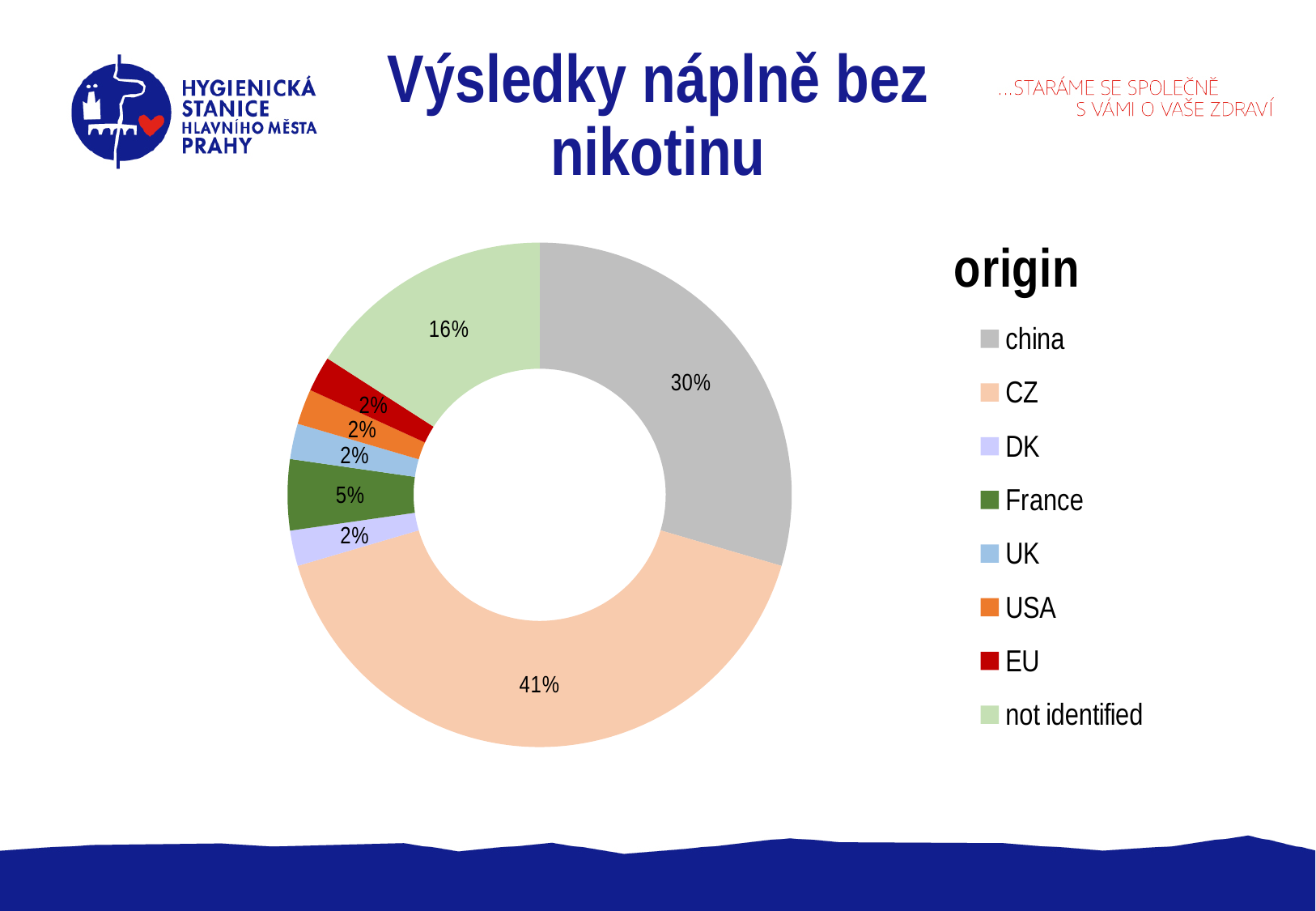
What percentage is shown for china? 30% What share of the chart does CZ account for? 41% How many categories does the chart show? 8 What percentage is shown for France? 5% Which origin has the largest share of the chart? CZ Which is larger, the share for France or the share for UK? France What kind of chart is shown on the slide? doughnut chart What percentage is shown for DK? 2% What is the difference in percentage points between china and not identified? 14 What percentage is shown for not identified? 16% What is the difference in percentage points between CZ and china? 11 What is the title of the chart? origin